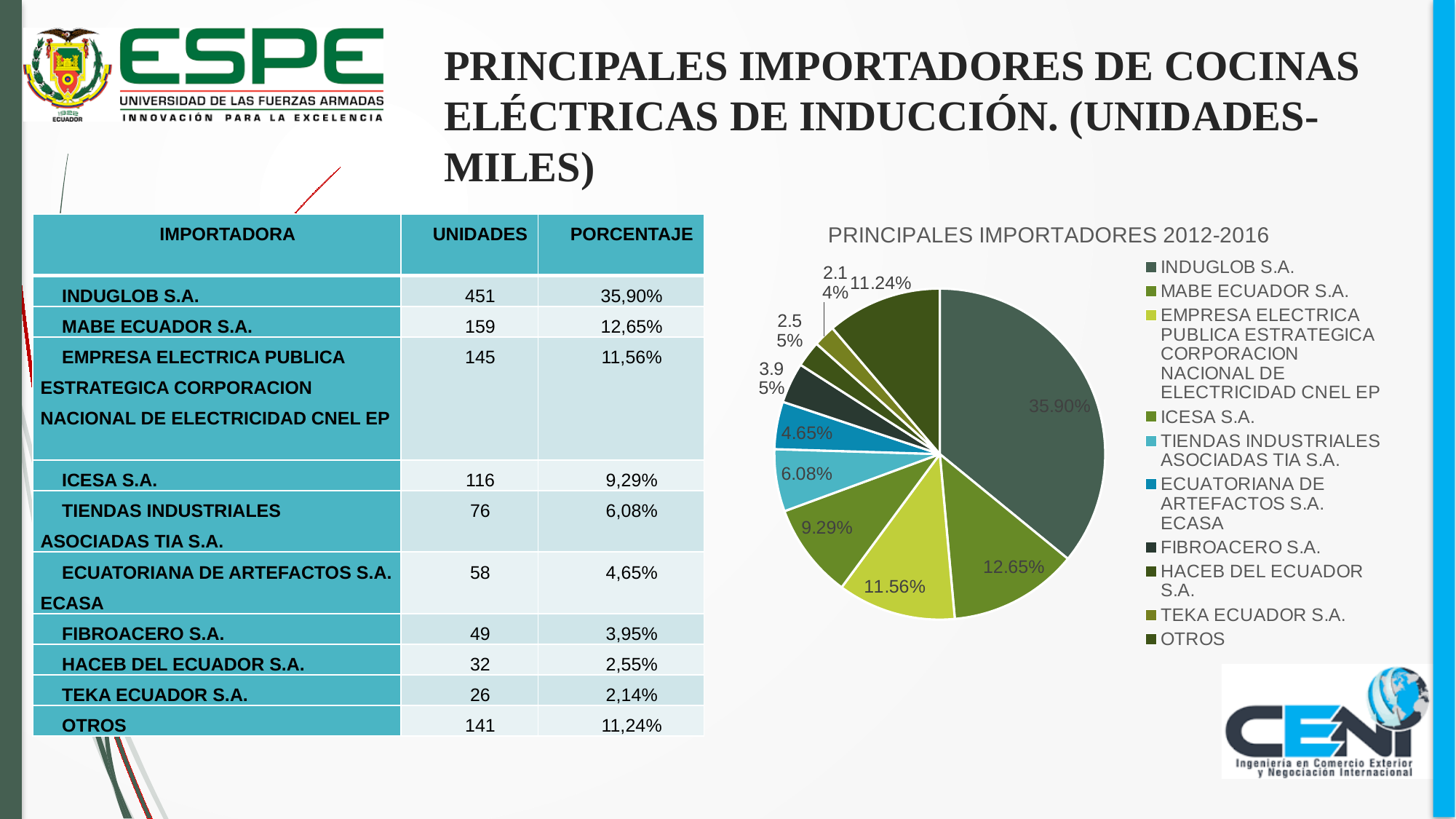
What share of the pie does MABE ECUADOR S.A. hold? 12.65% Which slice of the pie chart is the smallest? TEKA ECUADOR S.A. How many slices does the pie chart have? 10 How many entries does the legend of the pie chart list? 10 What share of the pie does ICESA S.A. hold? 9.29% Which is larger in the pie chart, the share for ICESA S.A. or the share for TIENDAS INDUSTRIALES ASOCIADAS TIA S.A.? ICESA S.A. What is the title of the pie chart? PRINCIPALES IMPORTADORES 2012-2016 Which slice of the pie chart is the largest? INDUGLOB S.A. What share of the pie does OTROS hold? 11.24% What kind of chart is shown on the slide? pie chart What is the difference between the share for INDUGLOB S.A. and the share for MABE ECUADOR S.A. in the pie chart? 23.25%